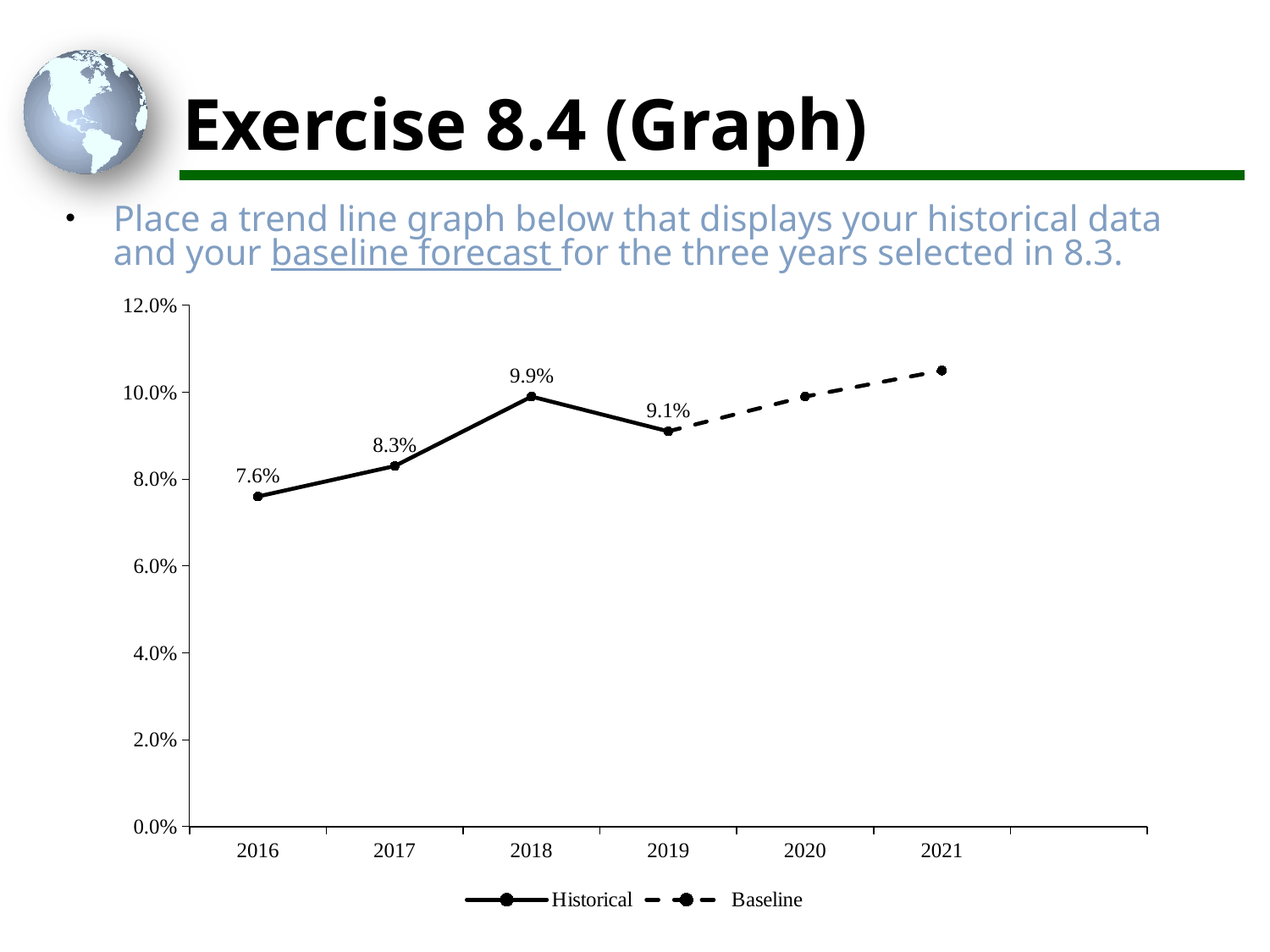
How many series does the legend list? 2 What is the Historical value for 2019? 9.1% In which year is the Historical series highest? 2018 What is the Historical value for 2016? 7.6% Which year has the larger Historical value, 2017 or 2019? 2019 What is the Historical value for 2018? 9.9% Which series is drawn with a dashed line? Baseline Is the Baseline value for 2020 greater or less than 8.0%? greater What kind of chart is shown on the slide? line chart What is the difference between the Historical values for 2018 and 2017? 1.6% In which year is the Historical series lowest? 2016 Is the Baseline value for 2021 greater or less than 10.0%? greater